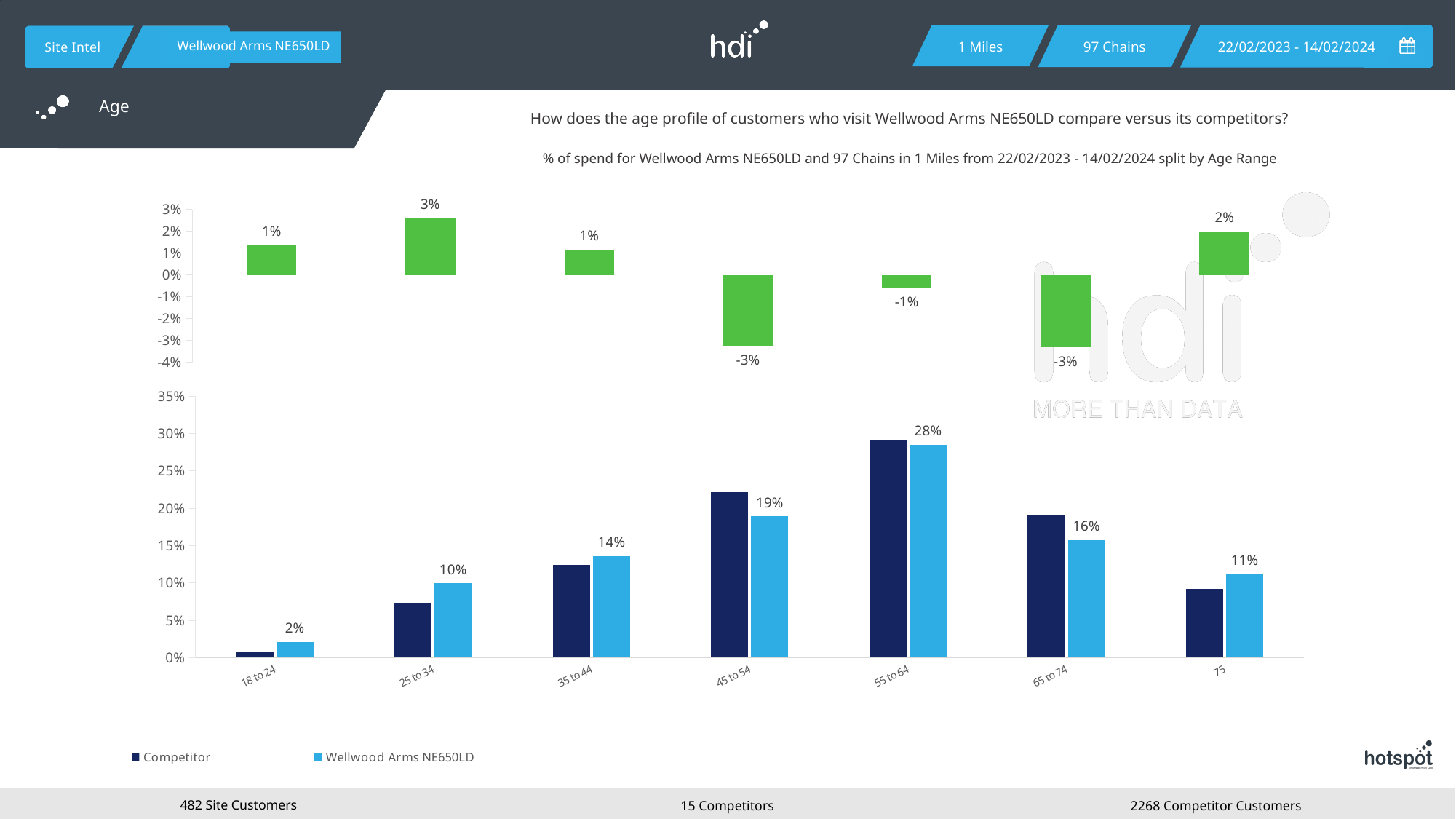
What kind of chart is the bottom chart? Bar chart In the bottom chart, what is the value for Wellwood Arms NE650LD in the 18 to 24 age range? 2% In the bottom chart, is the Competitor value for 45 to 54 greater or less than 20%? greater In the bottom chart, which age range has the lowest Wellwood Arms NE650LD value? 18 to 24 In the bottom chart, what is the difference between the Wellwood Arms NE650LD values for 55 to 64 and 45 to 54? 9% In the top chart, what is the value shown for the 25 to 34 age range? 3% How many series does the legend of the bottom chart list? 2 In the bottom chart, what is the value for Wellwood Arms NE650LD in the 55 to 64 age range? 28% In the bottom chart, which age range has the highest Wellwood Arms NE650LD value? 55 to 64 How many age range categories are shown on the x axis of the bottom chart? 7 In the bottom chart, which is larger for the 65 to 74 age range, the Competitor value or the Wellwood Arms NE650LD value? Competitor In the bottom chart, is the Competitor value for 25 to 34 greater or less than 10%? less